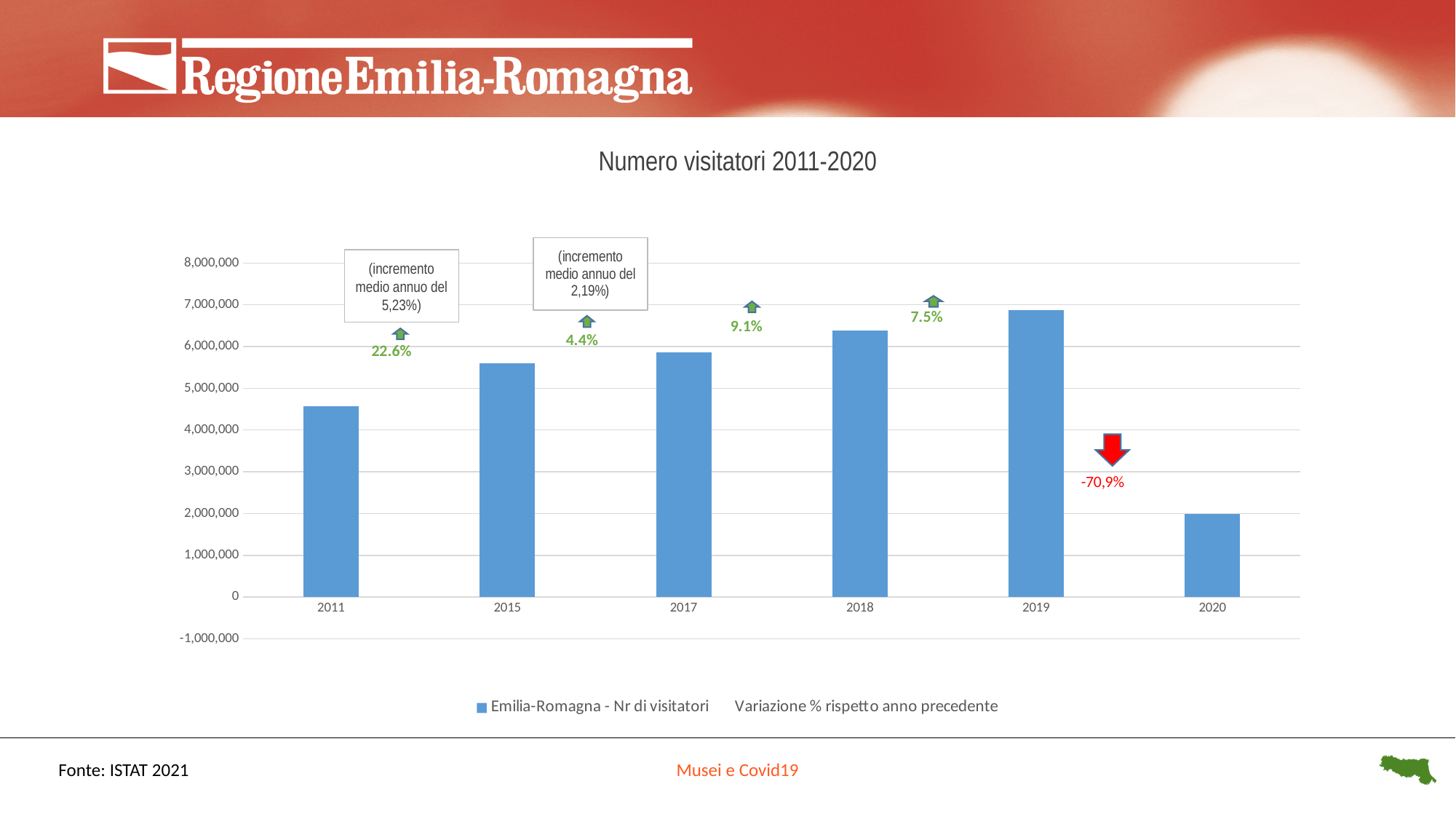
How many entries does the chart legend list? 2 Is the number of visitors in 2019 greater or less than 6,000,000? greater How many years are shown on the x axis of the chart? 6 Which year has the highest number of visitors? 2019 Which year has the lowest number of visitors? 2020 Which year has more visitors, 2011 or 2018? 2018 Is the number of visitors in 2020 greater or less than 3,000,000? less What is the title of the chart? Numero visitatori 2011-2020 What kind of chart is shown on the slide? Bar chart What percentage change is shown for 2020 compared with the previous year? -70,9%